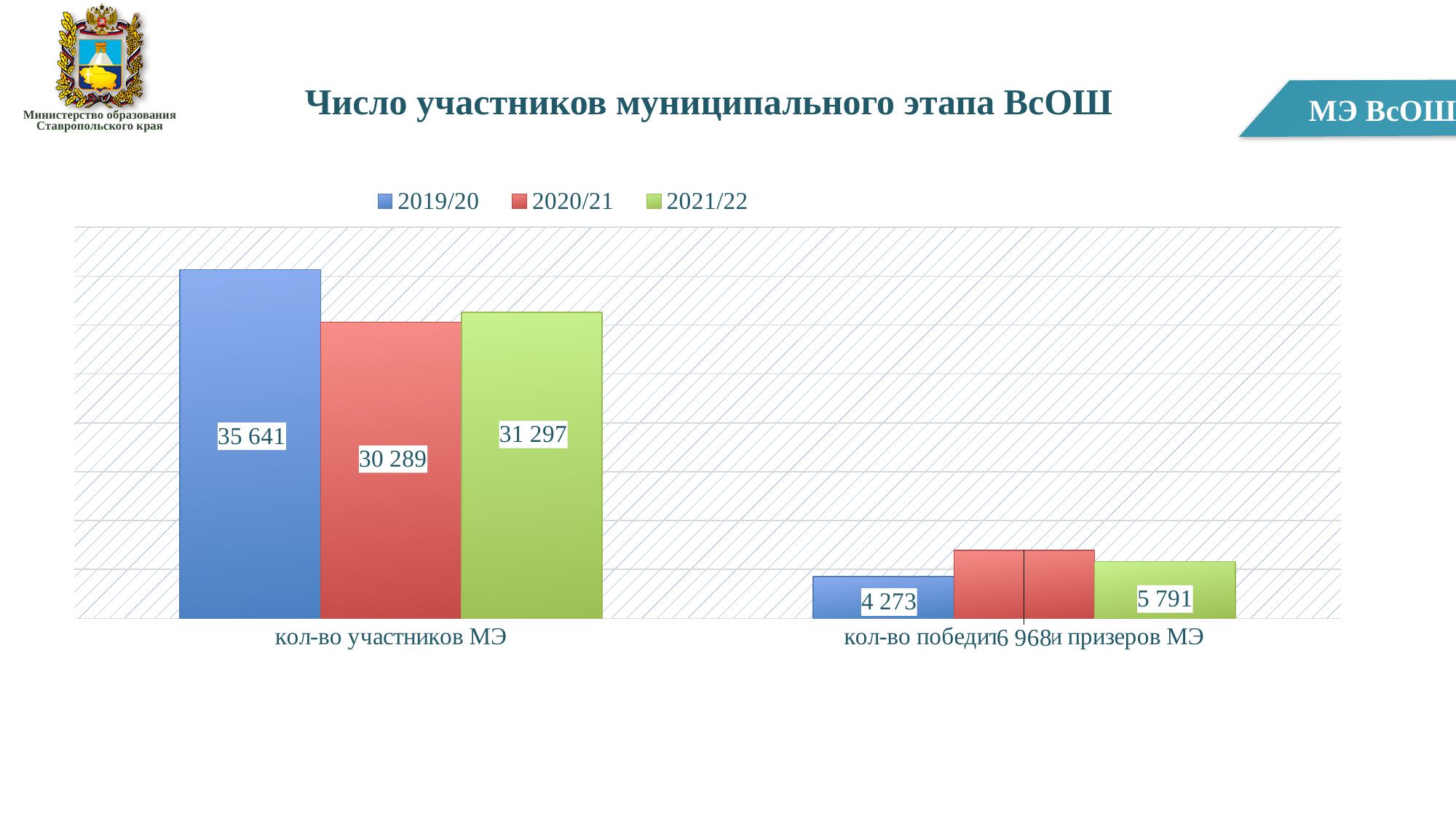
What is the difference between the 2019/20 and 2020/21 values in the category "кол-во участников МЭ"? 5 352 How many series does the legend list? 3 What is the value for 2019/20 in the category "кол-во участников МЭ"? 35 641 What kind of chart is shown on the slide? Bar chart What is the value for 2020/21 in the category "кол-во участников МЭ"? 30 289 In the category "кол-во участников МЭ", which is larger: the 2020/21 value or the 2021/22 value? 2021/22 What is the value for 2021/22 in the category "кол-во участников МЭ"? 31 297 What is the title of the chart? Число участников муниципального этапа ВсОШ What is the value for 2021/22 in the category "кол-во победителей и призеров МЭ"? 5 791 Which series has the highest value in the category "кол-во участников МЭ"? 2019/20 Which series has the lowest value in the category "кол-во победителей и призеров МЭ"? 2019/20 What is the value for 2019/20 in the category "кол-во победителей и призеров МЭ"? 4 273